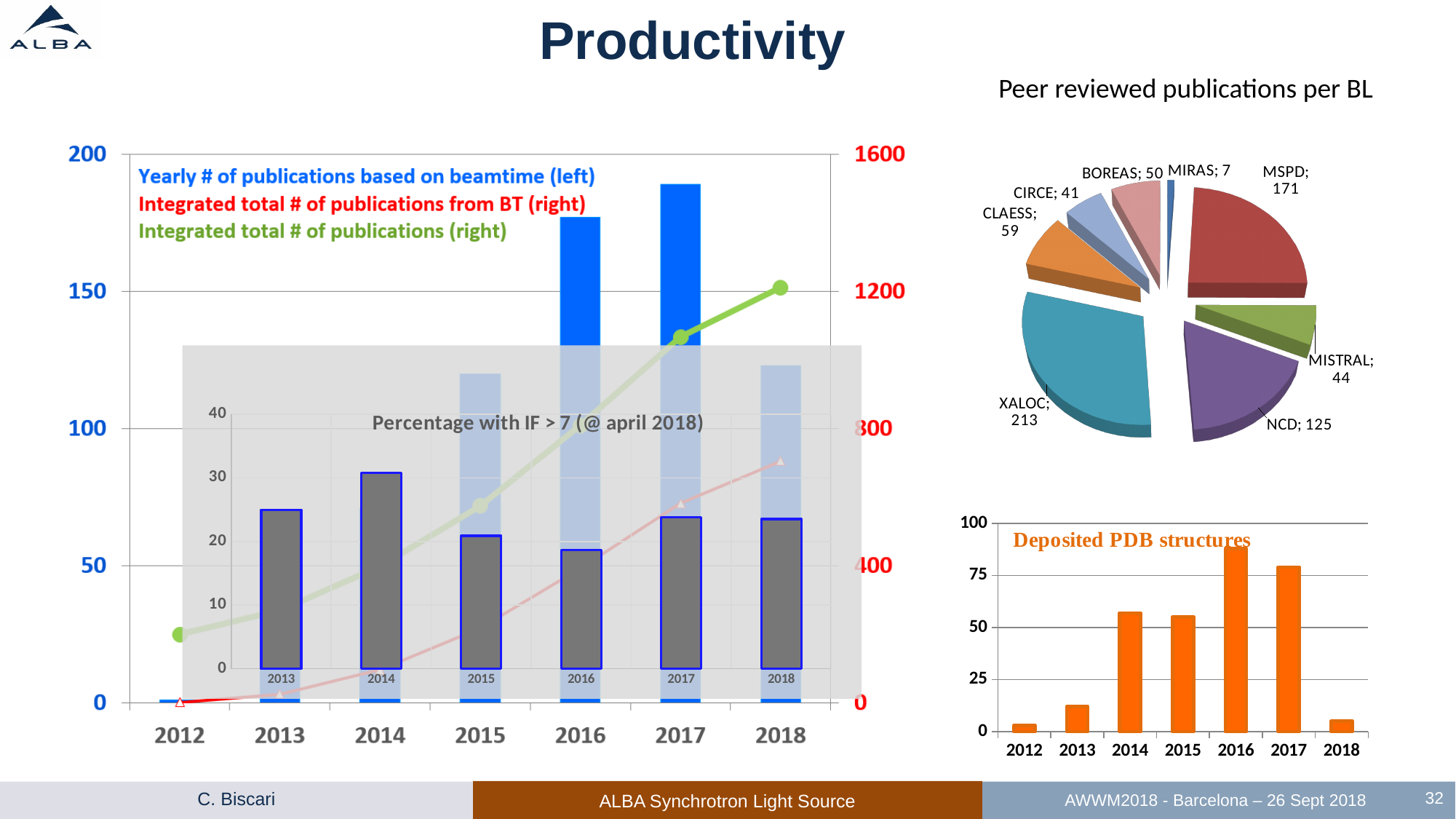
In the 'Deposited PDB structures' chart, is the value for 2018 greater or less than 25? less In the 'Peer reviewed publications per BL' pie chart, which is larger, BOREAS or CIRCE? BOREAS In the 'Peer reviewed publications per BL' pie chart, what is the value for XALOC? 213 In the 'Deposited PDB structures' chart, which year has the highest value? 2016 In the inset chart 'Percentage with IF > 7 (@ april 2018)', which year has the highest bar? 2014 In the 'Peer reviewed publications per BL' pie chart, which beamline has the smallest slice? MIRAS In the 'Peer reviewed publications per BL' pie chart, what share of the total does XALOC represent? 30% In the 'Deposited PDB structures' chart, is the value for 2016 greater or less than 75? greater In the 'Peer reviewed publications per BL' pie chart, what is the value for MSPD? 171 In the 'Peer reviewed publications per BL' pie chart, what is the difference between NCD and CLAESS? 66 In the 'Peer reviewed publications per BL' pie chart, how many beamlines are shown? 8 What kind of chart is the 'Deposited PDB structures' chart? bar chart